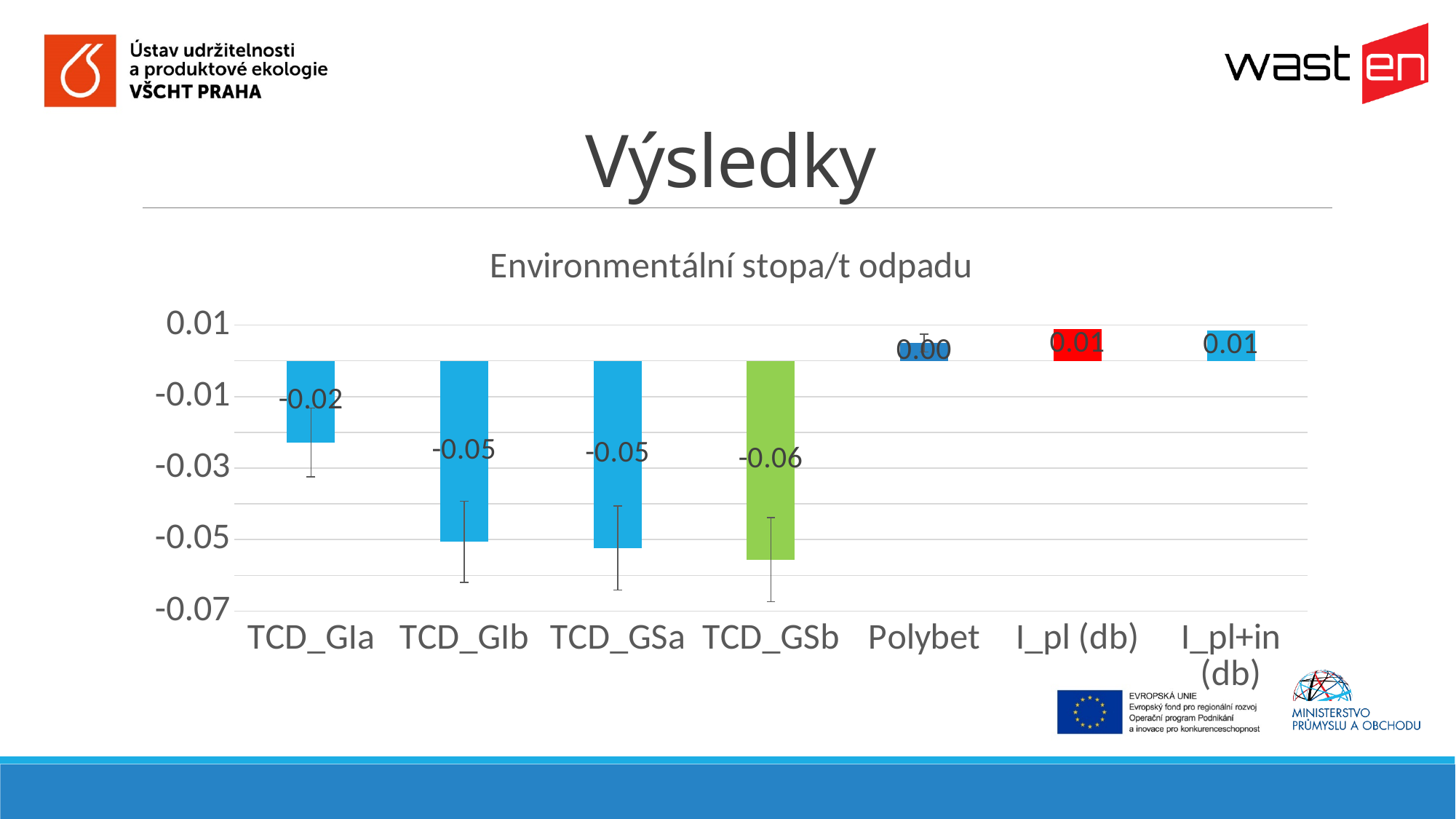
Which is larger, the value for TCD_GIa or the value for TCD_GSb? TCD_GIa What is the value for TCD_GSb in the chart? -0.06 What is the title of the chart? Environmentální stopa/t odpadu What kind of chart is shown on the slide? Bar chart What is the difference between the values for TCD_GIa and TCD_GSb? 0.04 What is the value for Polybet in the chart? 0.00 What is the value for I_pl (db) in the chart? 0.01 Which is larger, the value for Polybet or the value for TCD_GIb? Polybet How many categories are shown on the x axis of the chart? 7 What is the difference between the values for TCD_GIb and TCD_GIa? 0.03 Which category has the lowest value in the chart? TCD_GSb What is the value for TCD_GIa in the chart? -0.02